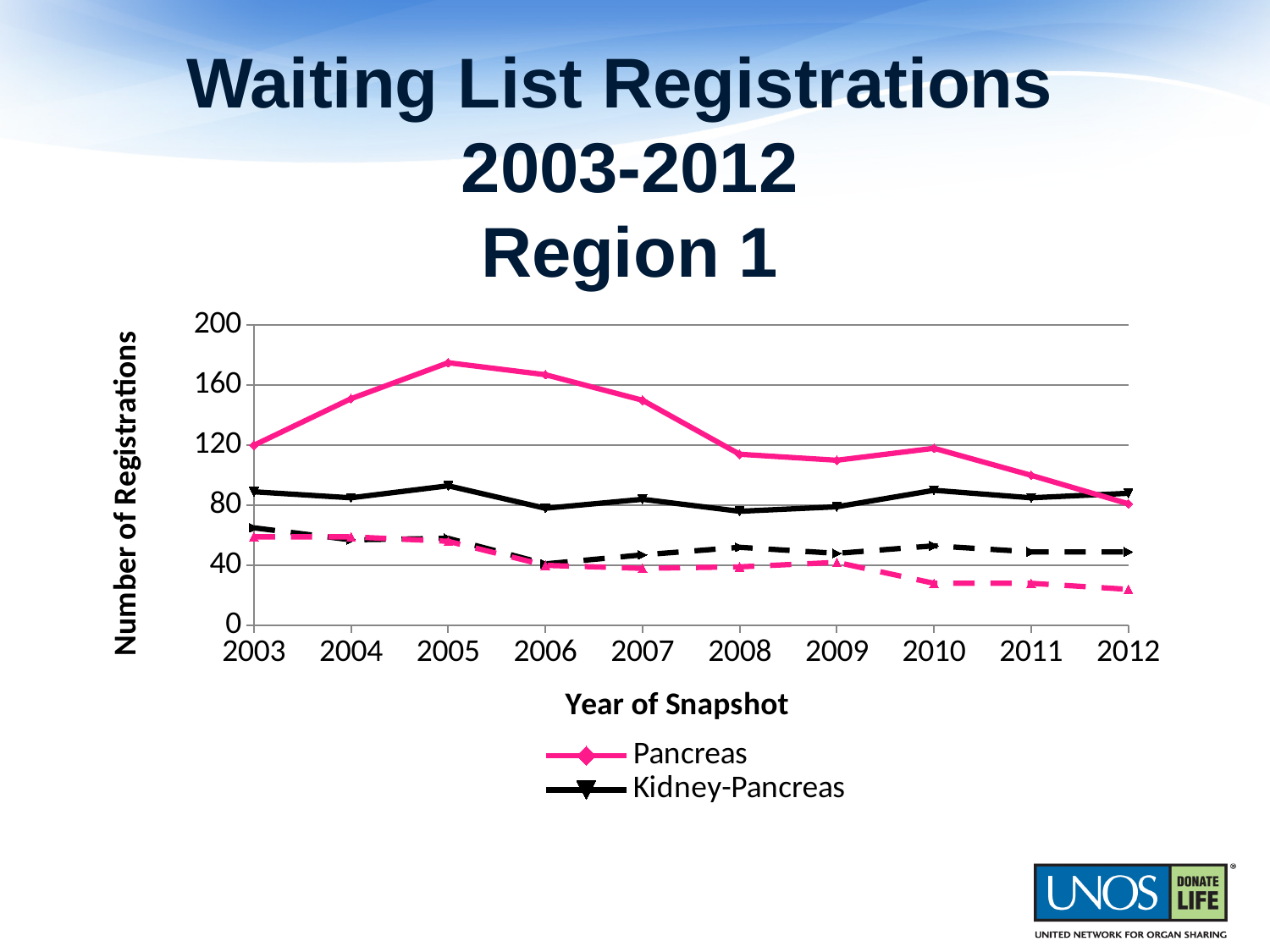
Does the Pancreas series rise or fall from 2005 to 2012? fall In which year does the Pancreas series reach its highest value? 2005 How many series does the legend list? 2 In which year does the Pancreas series reach its lowest value? 2012 What is the title of the x axis? Year of Snapshot Is the Pancreas value for 2012 greater or less than 120? less Is the Kidney-Pancreas value for 2005 greater or less than 80? greater In 2003, which series has the larger value, Pancreas or Kidney-Pancreas? Pancreas Is the Pancreas value for 2005 greater or less than 160? greater How many years are plotted along the x axis? 10 What kind of chart is shown on the slide? line chart